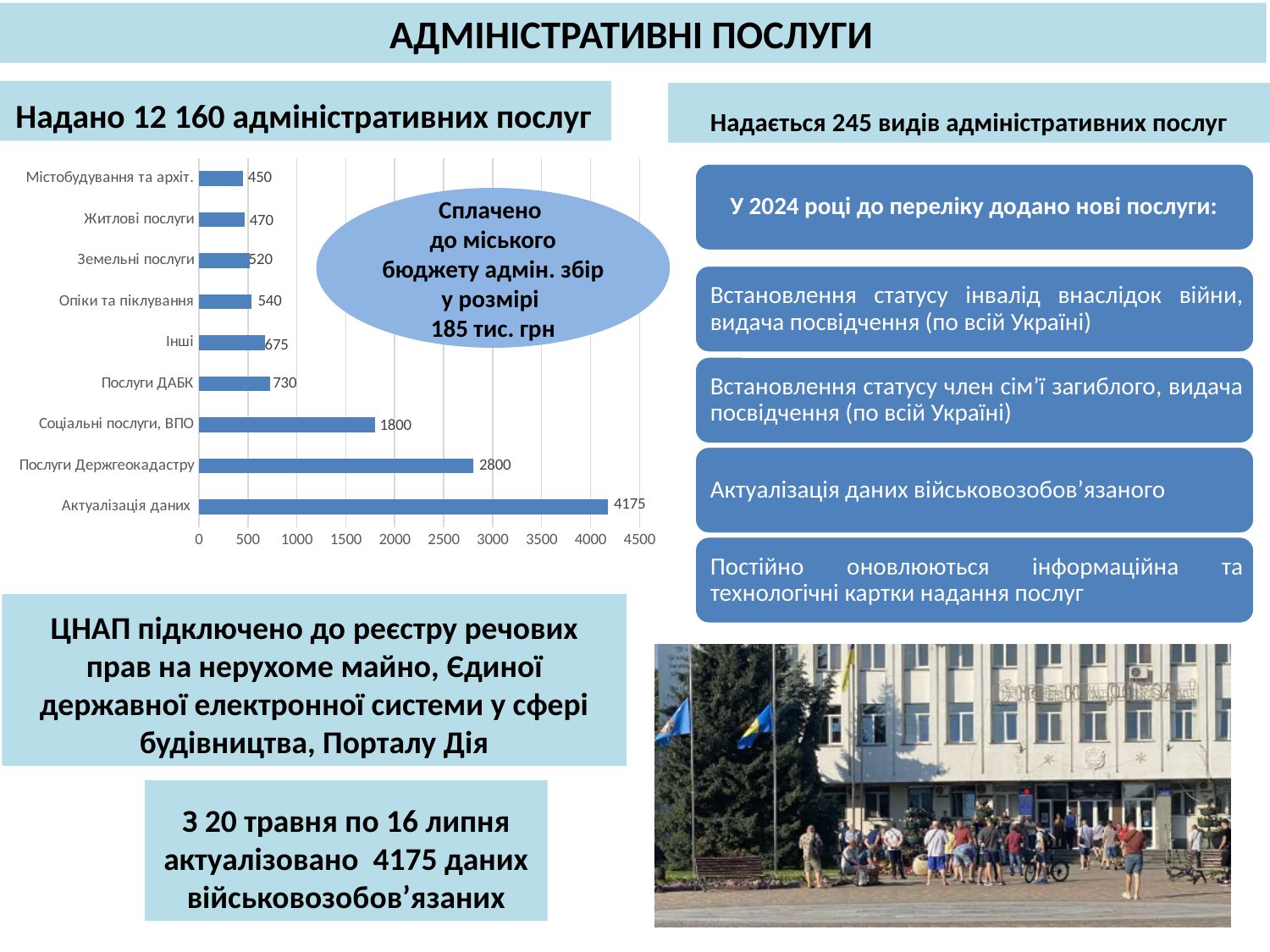
Which category has the lowest value in the bar chart? Містобудування та архіт. What is the difference between the values for Послуги Держгеокадастру and Соціальні послуги, ВПО? 1000 What value is shown for Актуалізація даних? 4175 Which is larger, the value for Послуги ДАБК or the value for Інші? Послуги ДАБК How many categories are shown in the bar chart? 9 What is the maximum value shown on the horizontal axis of the chart? 4500 Is the value for Соціальні послуги, ВПО greater or less than 1500? greater What value is shown for Послуги Держгеокадастру? 2800 What value is shown for Опіки та піклування? 540 What value is shown for Соціальні послуги, ВПО? 1800 What kind of chart is shown on the slide? bar chart Which category has the highest value in the bar chart? Актуалізація даних